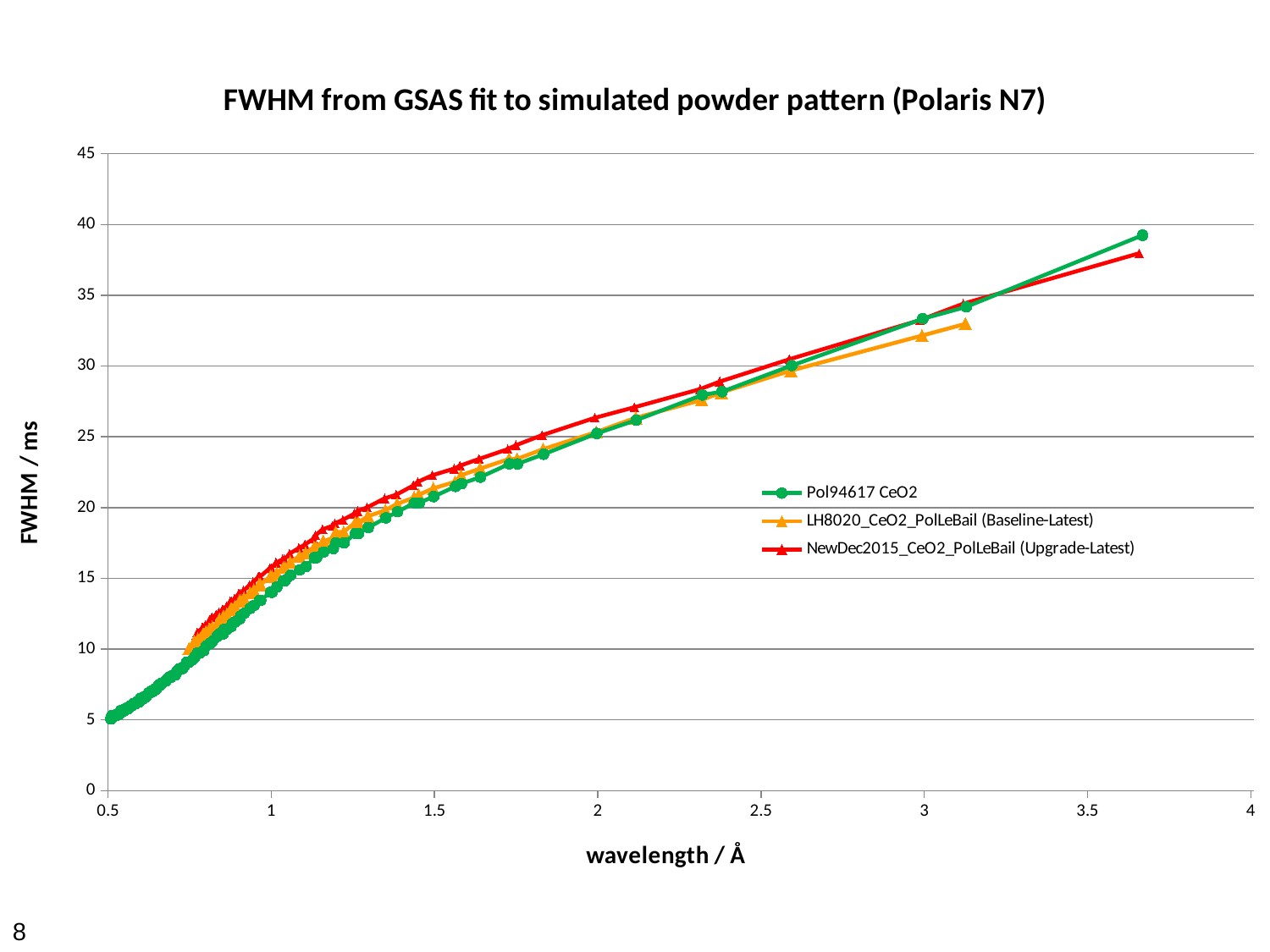
Is the value for LH8020_CeO2_PolLeBail (Baseline-Latest) at its highest wavelength point (around 3.12 Å) greater or less than 35? less Which series reaches the lowest FWHM value on the chart? Pol94617 CeO2 Is the value for NewDec2015_CeO2_PolLeBail (Upgrade-Latest) at its highest wavelength point (around 3.66 Å) greater or less than 40? less At the highest wavelength point (around 3.66 Å), which series has the larger FWHM: Pol94617 CeO2 or NewDec2015_CeO2_PolLeBail (Upgrade-Latest)? Pol94617 CeO2 Is the value for Pol94617 CeO2 at wavelength 0.5 Å greater or less than 10? less What kind of chart is shown on the slide? line chart At wavelength 1.5 Å, which series has the larger FWHM: NewDec2015_CeO2_PolLeBail (Upgrade-Latest) or Pol94617 CeO2? NewDec2015_CeO2_PolLeBail (Upgrade-Latest) How many series does the legend list? 3 What is the label on the vertical axis? FWHM / ms Do the FWHM values rise or fall as wavelength increases? rise What is the title of the chart? FWHM from GSAS fit to simulated powder pattern (Polaris N7)